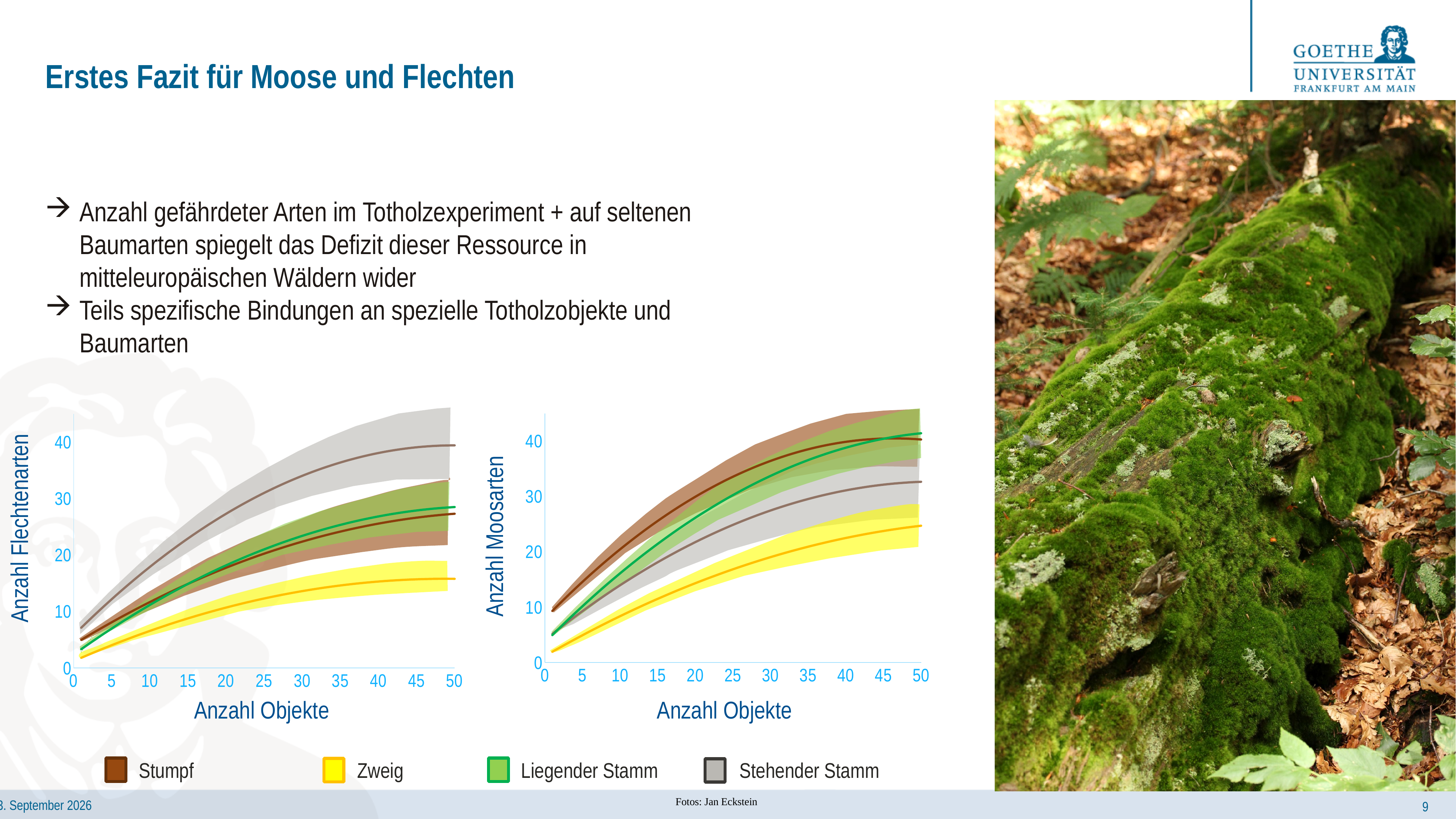
Which colour represents Zweig in the legend? Yellow What is the x-axis label of the right chart? Anzahl Objekte In the left chart (Anzahl Flechtenarten), is the value for Zweig at 50 Objekte greater or less than 20? less In the right chart (Anzahl Moosarten), do the values rise or fall as Anzahl Objekte increases? Rise How many series does the shared legend below the charts list? 4 In the left chart (Anzahl Flechtenarten), which series has the lowest value at 50 Objekte? Zweig In the right chart (Anzahl Moosarten), is the value for Zweig at 50 Objekte greater or less than 20? greater In the left chart (Anzahl Flechtenarten), which series has the highest value at 50 Objekte? Stehender Stamm In the right chart (Anzahl Moosarten), which is larger at 50 Objekte: Stumpf or Stehender Stamm? Stumpf What kind of chart is the left chart (Anzahl Flechtenarten)? Line chart In the right chart (Anzahl Moosarten), which series has the lowest value at 50 Objekte? Zweig In the left chart (Anzahl Flechtenarten), is the value for Stehender Stamm at 50 Objekte greater or less than 30? greater